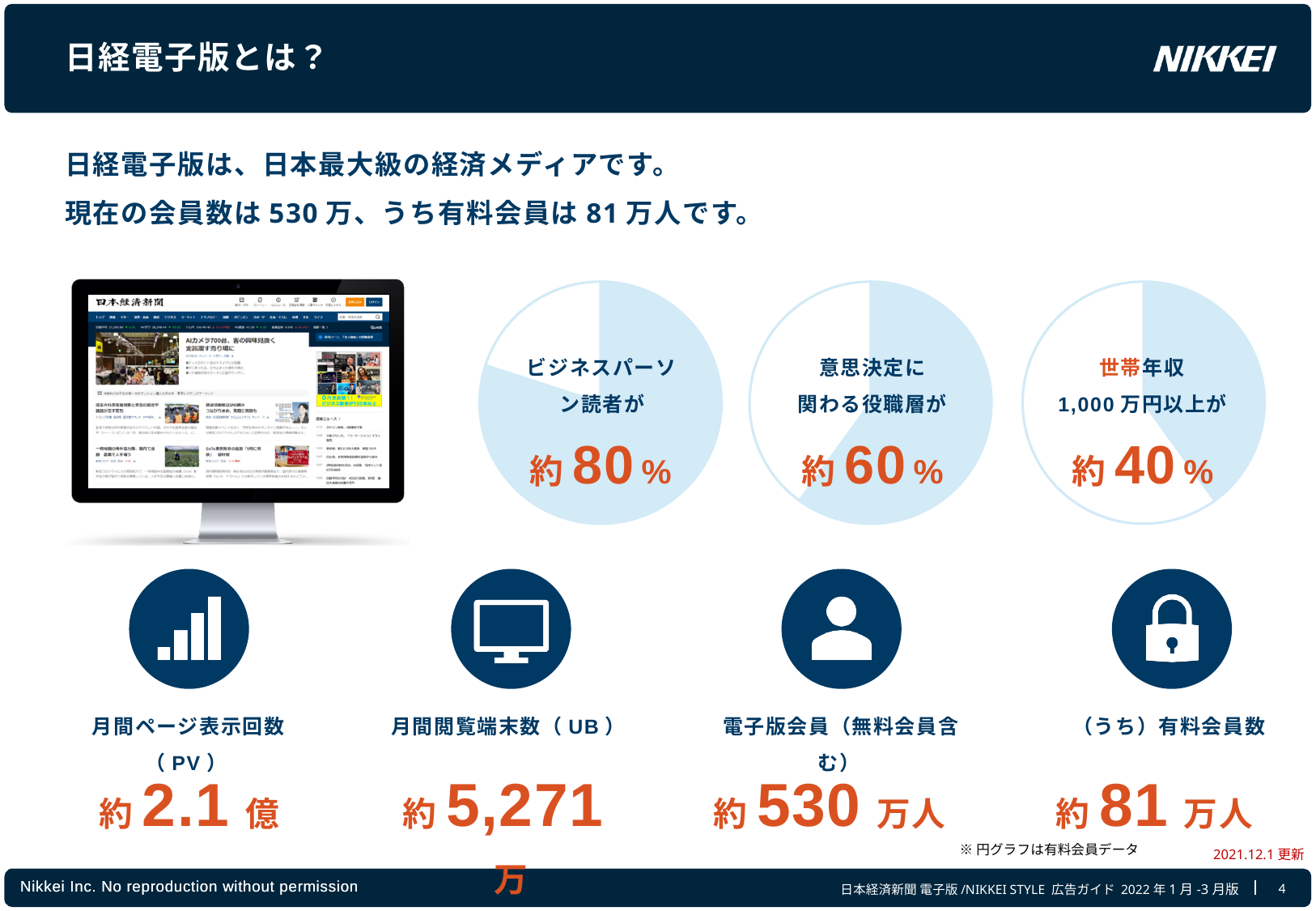
Which of the three pie charts shows the largest highlighted share? ビジネスパーソン読者 (約80%) What kind of charts are the three circular charts on the slide? Pie charts In the right pie chart, what share of readers have a household income of 10 million yen or more (世帯年収1,000万円以上)? 約40% Is the share for business-person readers (left pie) larger or smaller than the share for decision-making executives (middle pie)? Larger Which of the three pie charts shows the smallest highlighted share? 世帯年収1,000万円以上 (約40%) What colour is used for the highlighted percentage text in the pie charts? Orange In the middle pie chart, what share is shown for decision-making executives (意思決定に関わる役職層)? 約60% In the left pie chart, what share of readers are business persons (ビジネスパーソン読者)? 約80% Is the share for household income of 10 million yen or more (right pie) greater or less than 50%? less According to the note at the bottom of the slide, whose data do the pie charts represent? 有料会員データ (paid member data) How many pie charts are shown on the slide? 3 Is the share for decision-making executives (middle pie) greater or less than 50%? greater